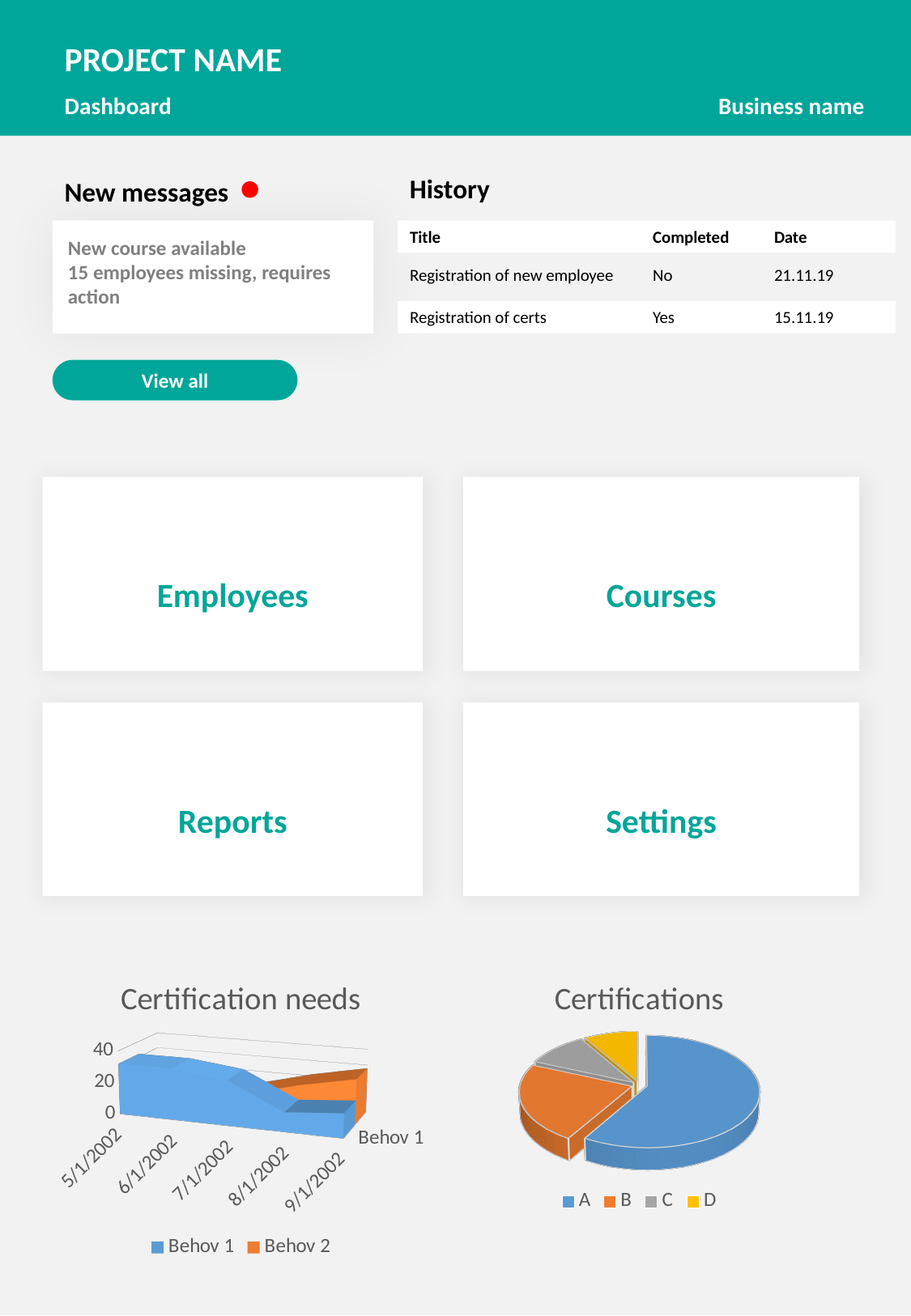
In the "Certification needs" chart, how many dates are shown on the x axis? 5 What kind of chart is the "Certification needs" chart? area chart In the "Certifications" chart, which slice is larger, B or C? B In the "Certification needs" chart, is the value for Behov 1 at 9/1/2002 greater or less than 20? less In the "Certifications" chart, which category has the smallest slice? D In the "Certifications" chart, which category has the largest slice? A In the "Certification needs" chart, does the Behov 1 series rise or fall from 5/1/2002 to 9/1/2002? fall In the "Certifications" chart, what colour is the slice for category A? blue In the "Certification needs" chart, what is the first date shown on the x axis? 5/1/2002 In the "Certification needs" chart, how many series does the legend list? 2 What kind of chart is the "Certifications" chart? pie chart In the "Certifications" chart, how many categories does the legend list? 4